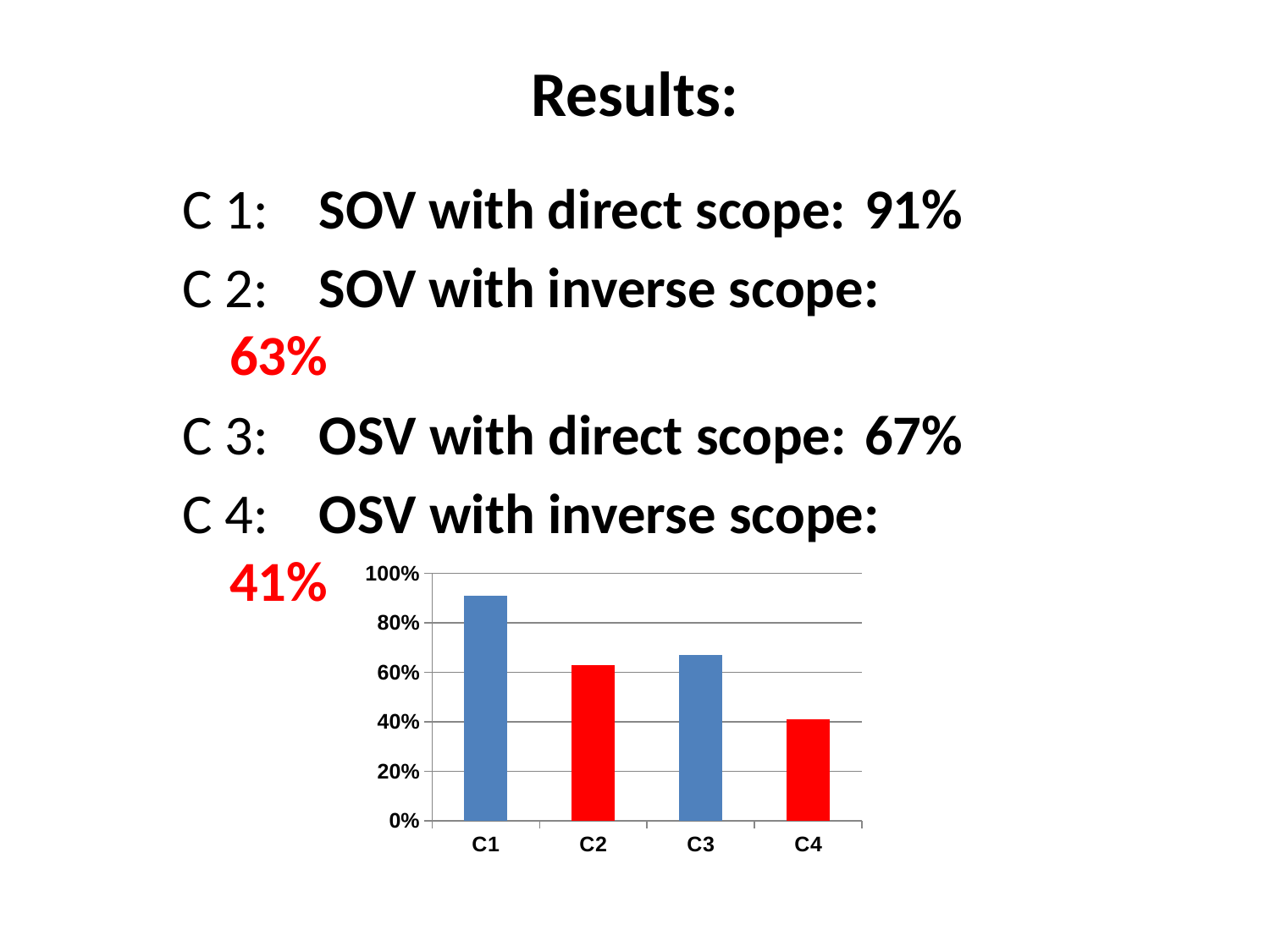
Is the value for C4 greater or less than 60%? less What is the value for C2 according to the slide? 63% How many categories are shown on the x axis of the chart? 4 Is the value for C1 greater or less than 80%? greater What type of chart is shown on the slide? bar chart Which is larger, the value for C1 or the value for C3? C1 What is the difference between the values for C1 and C4? 50% What is the value for C4 according to the slide? 41% What is the value for C1 according to the slide? 91% Which category has the highest bar in the chart? C1 What colour are the bars for C2 and C4 in the chart? red Which category has the lowest bar in the chart? C4